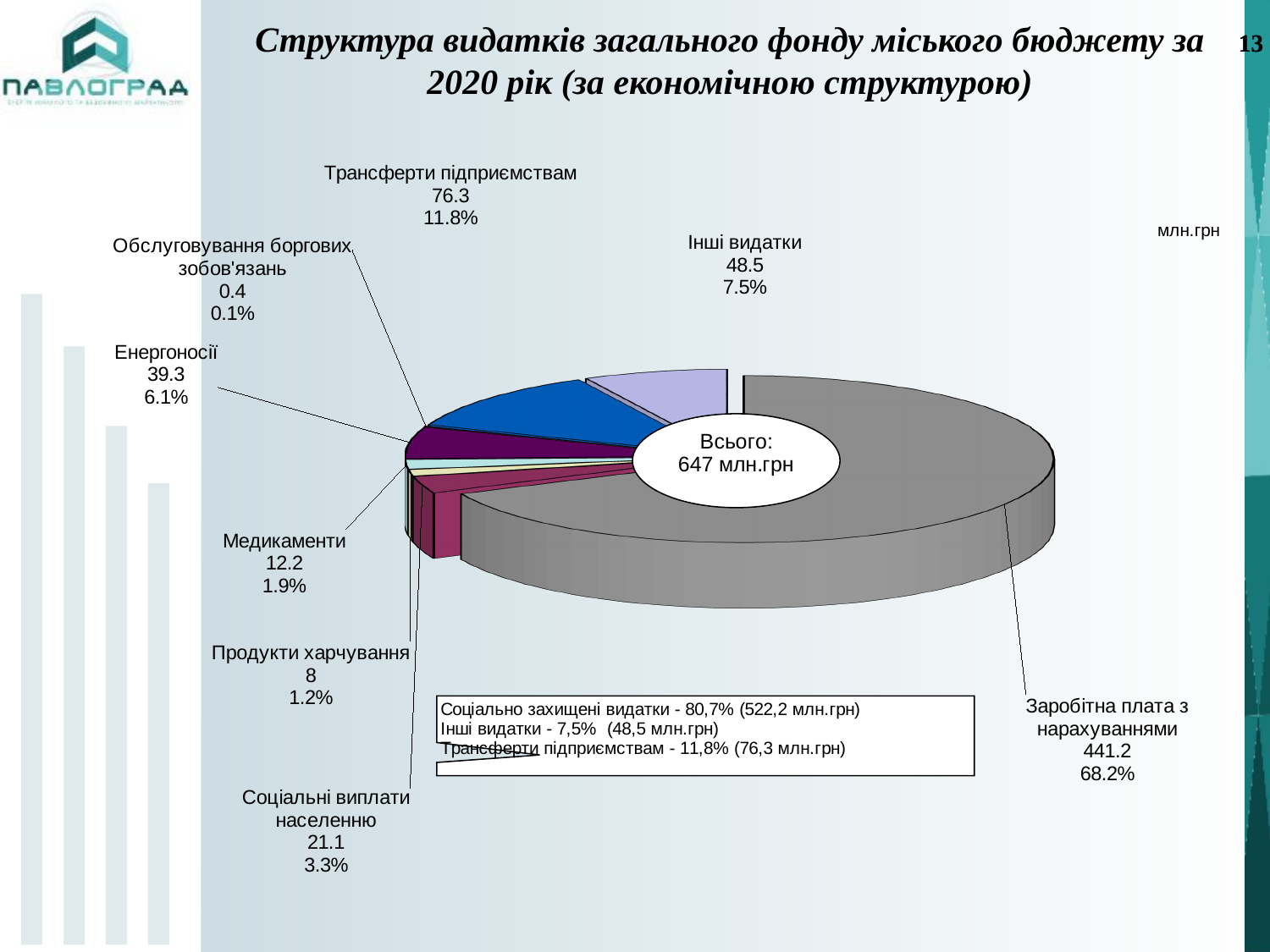
Which category has the smallest slice of the pie? Обслуговування боргових зобов'язань What share of the pie does Трансферти підприємствам represent? 11.8% What total is shown in the centre of the pie chart? 647 млн.грн How many categories are shown in the pie chart? 8 What is the value for Продукти харчування? 8 What share of the pie does Інші видатки represent? 7.5% Which category has the largest slice of the pie? Заробітна плата з нарахуваннями What type of chart is shown on the slide? pie chart What is the value for Заробітна плата з нарахуваннями? 441.2 What is the value for Енергоносії? 39.3 Which is larger, the value for Медикаменти or the value for Соціальні виплати населенню? Соціальні виплати населенню What is the difference between the values for Трансферти підприємствам and Інші видатки? 27.8